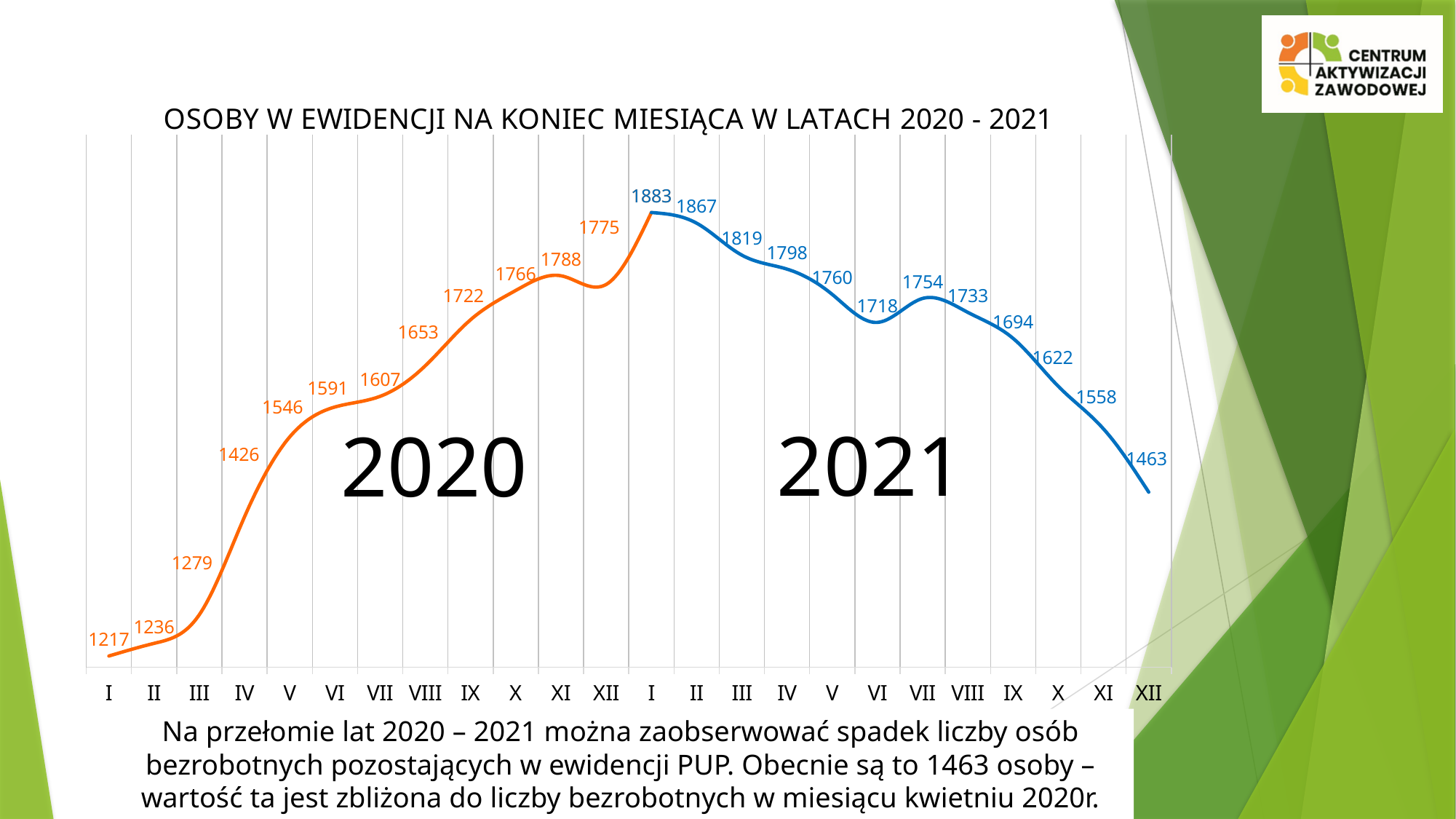
What is the value for month VIII of 2020? 1653 Do the values rise or fall along the x axis during 2021? fall What is the value for month I of 2020? 1217 Which month has the lowest value on the chart? I 2020 (1217) Which is larger, the value for month XI of 2020 or the value for month VII of 2021? XI 2020 (1788) What is the difference between the value for month XII of 2020 and month I of 2020? 558 What is the difference between the value for month I of 2021 and month XII of 2021? 420 How many data points are plotted on the chart? 24 What is the value for month XII of 2021? 1463 Which month has the highest value on the chart? I 2021 (1883) What type of chart is shown on the slide? line chart What is the value for month VI of 2021? 1718